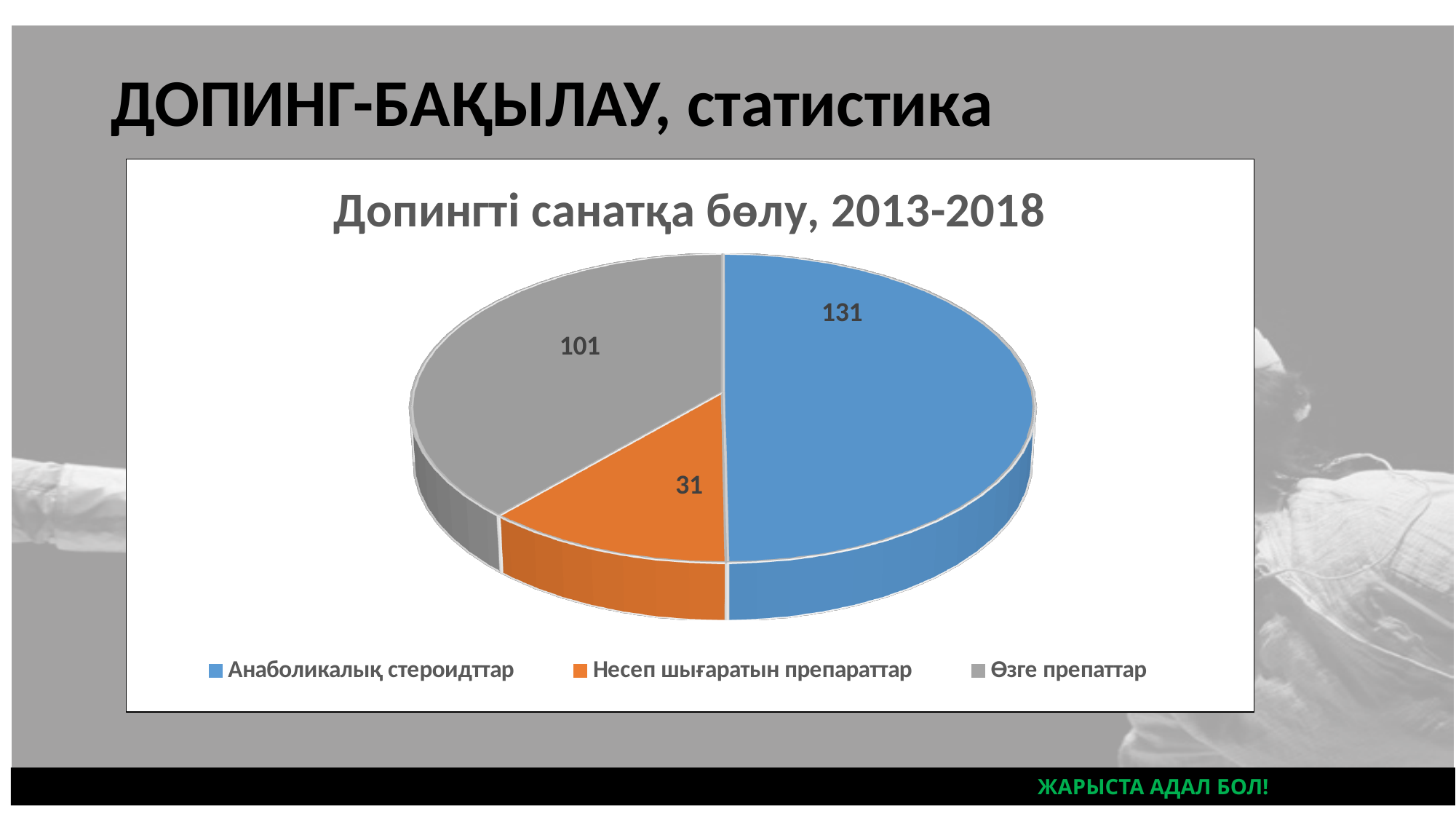
What is the title of the chart? Допингті санатқа бөлу, 2013-2018 What is the difference between the values for Өзге препаттар and Несеп шығаратын препараттар? 70 How many categories does the pie chart have? 3 What is the difference between the values for Анаболикалық стероидттар and Өзге препаттар? 30 Which is larger, the value for Өзге препаттар or the value for Несеп шығаратын препараттар? Өзге препаттар Which category has the smallest slice? Несеп шығаратын препараттар What is the value for Анаболикалық стероидттар? 131 What is the value for Несеп шығаратын препараттар? 31 What is the total of all slices in the pie chart? 263 Which category has the largest slice? Анаболикалық стероидттар What is the value for Өзге препаттар? 101 What type of chart is shown on the slide? Pie chart